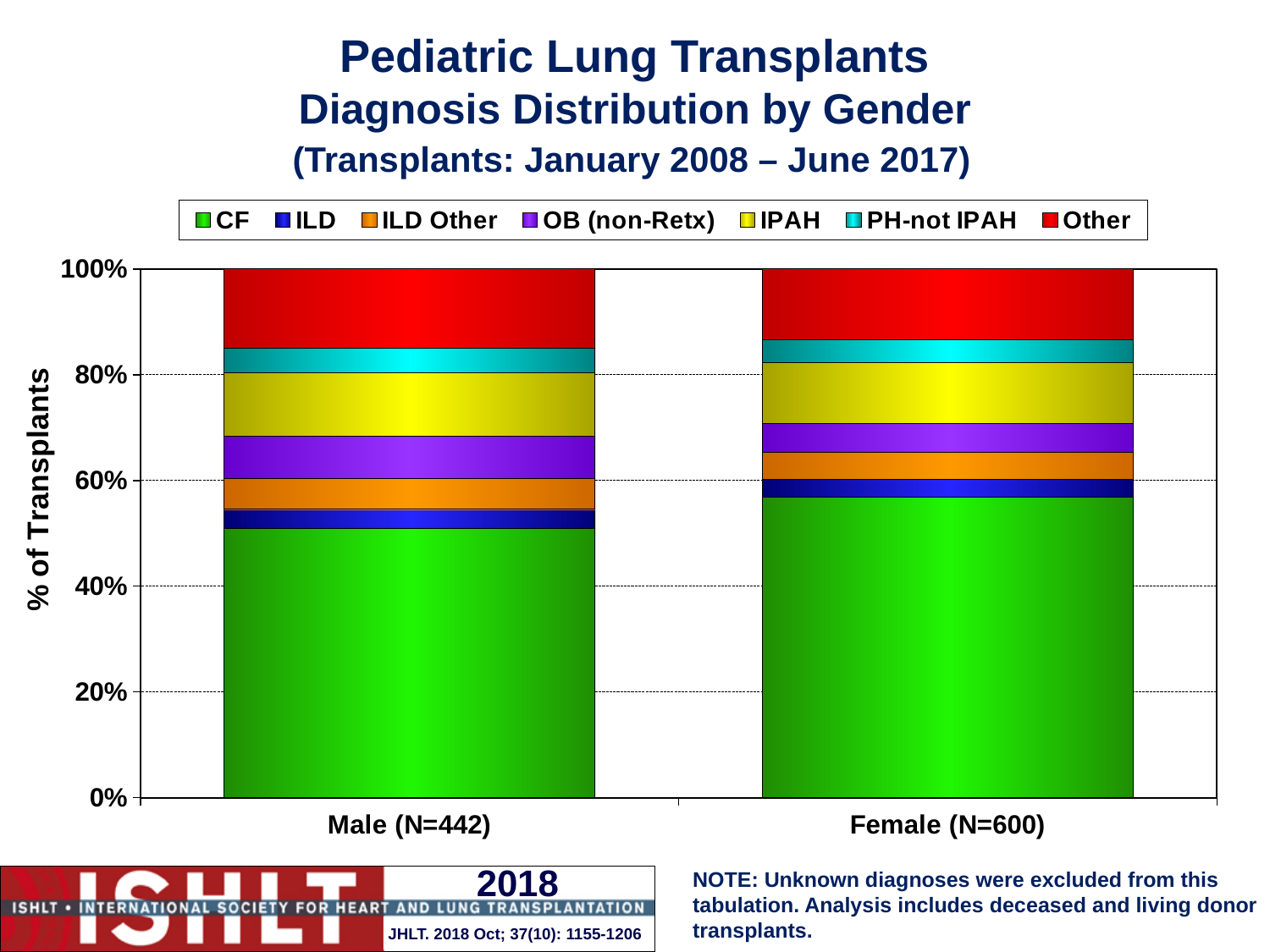
What is the label on the y axis? % of Transplants Which gender has the larger CF share, Male or Female? Female What is the N shown for the Female category? 600 Is the CF share for Male (N=442) greater or less than 40%? greater How many gender categories are plotted on the x axis? 2 What does the full stacked bar for Male (N=442) total? 100% Is the CF share for Female (N=600) greater or less than 60%? less What kind of chart is shown on the slide? Stacked bar chart How many series does the legend list? 7 What is the N shown for the Male category? 442 Is the CF share for Male (N=442) greater or less than 60%? less Which gender has the larger OB (non-Retx) share, Male or Female? Male